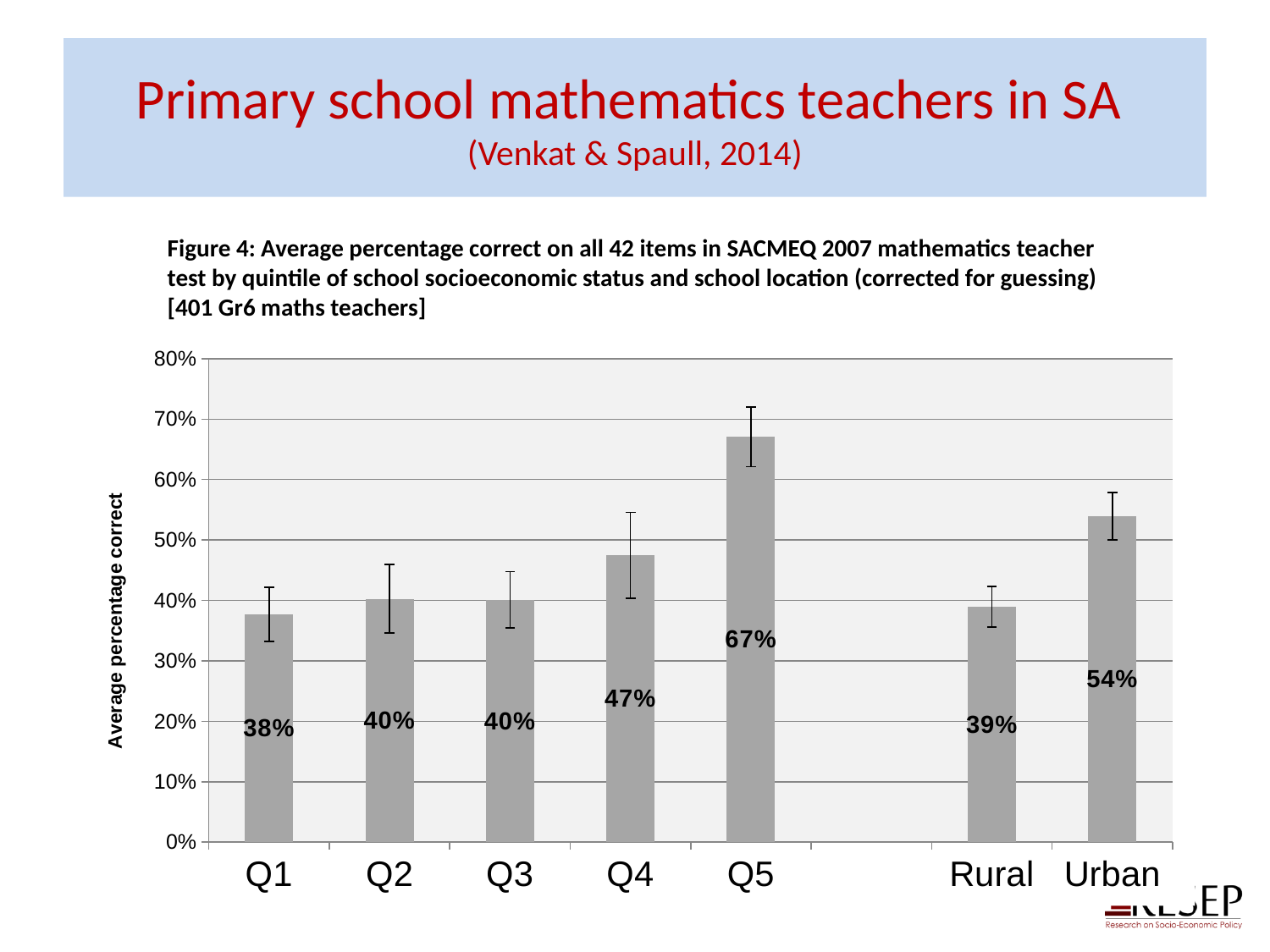
What is the average percentage correct for Q1? 38% What is the difference in average percentage correct between Urban and Rural schools? 15% How many categories are shown on the x axis? 7 What is the average percentage correct for Rural schools? 39% What is the average percentage correct for Urban schools? 54% Which has a higher average percentage correct, Q4 or Urban? Urban Is the value for Q5 greater or less than 60%? greater What kind of chart is shown on the slide? Bar chart What is the difference in average percentage correct between Q5 and Q1? 29% Which category has the lowest average percentage correct? Q1 Which category has the highest average percentage correct? Q5 What is the average percentage correct for Q5? 67%